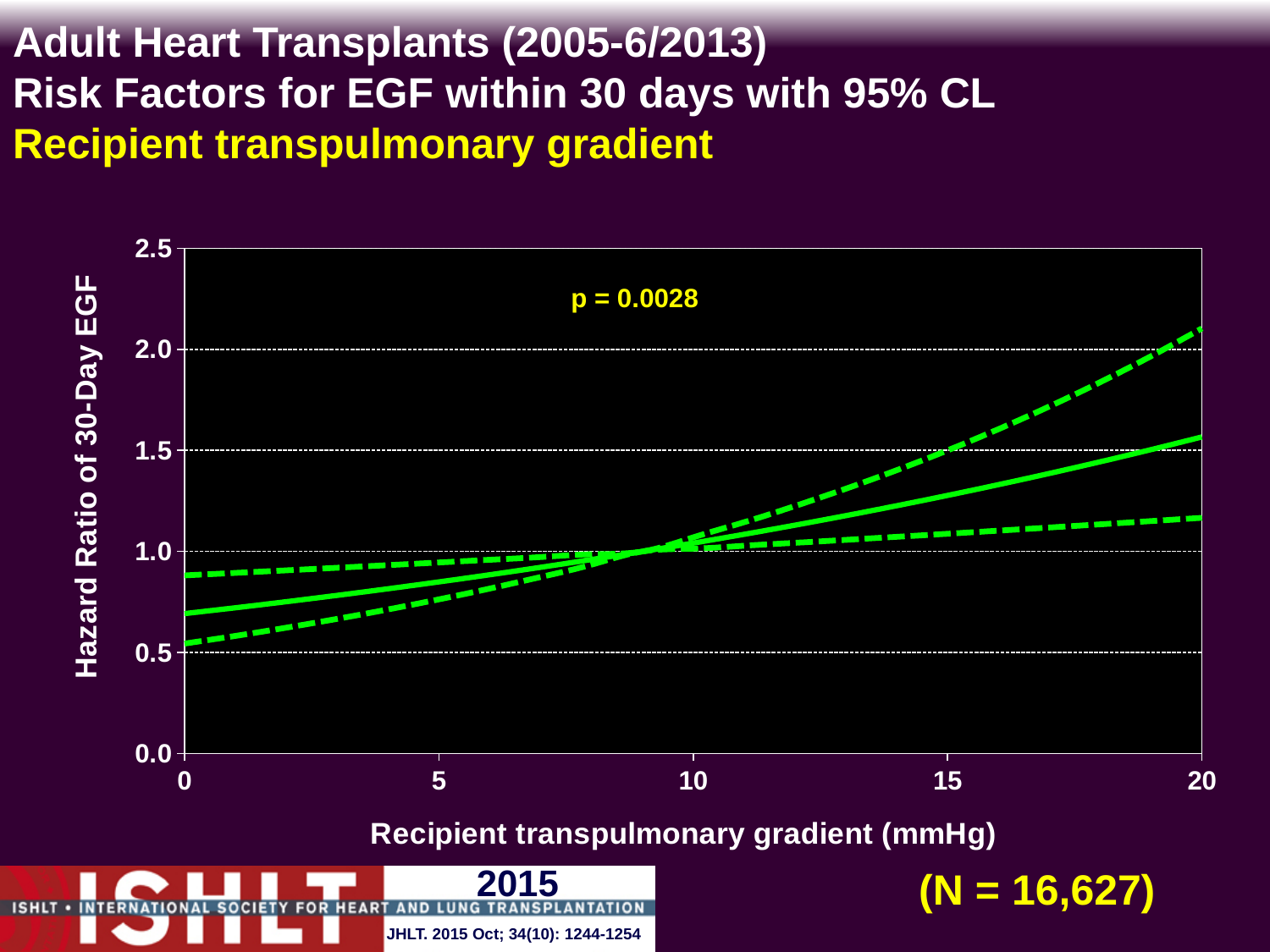
Is the hazard ratio (solid line) at a recipient transpulmonary gradient of 0 mmHg greater or less than 1.0? less Is the upper 95% confidence limit (upper dashed line) at 20 mmHg greater or less than 2.0? greater Is the hazard ratio (solid line) at a recipient transpulmonary gradient of 15 mmHg greater or less than 1.5? less What p-value is printed on the chart? p = 0.0028 How many lines are plotted on the chart? 3 What kind of chart is shown on the slide? line chart Does the solid hazard ratio line rise or fall as recipient transpulmonary gradient increases from 0 to 20 mmHg? rise What is the label of the y-axis? Hazard Ratio of 30-Day EGF